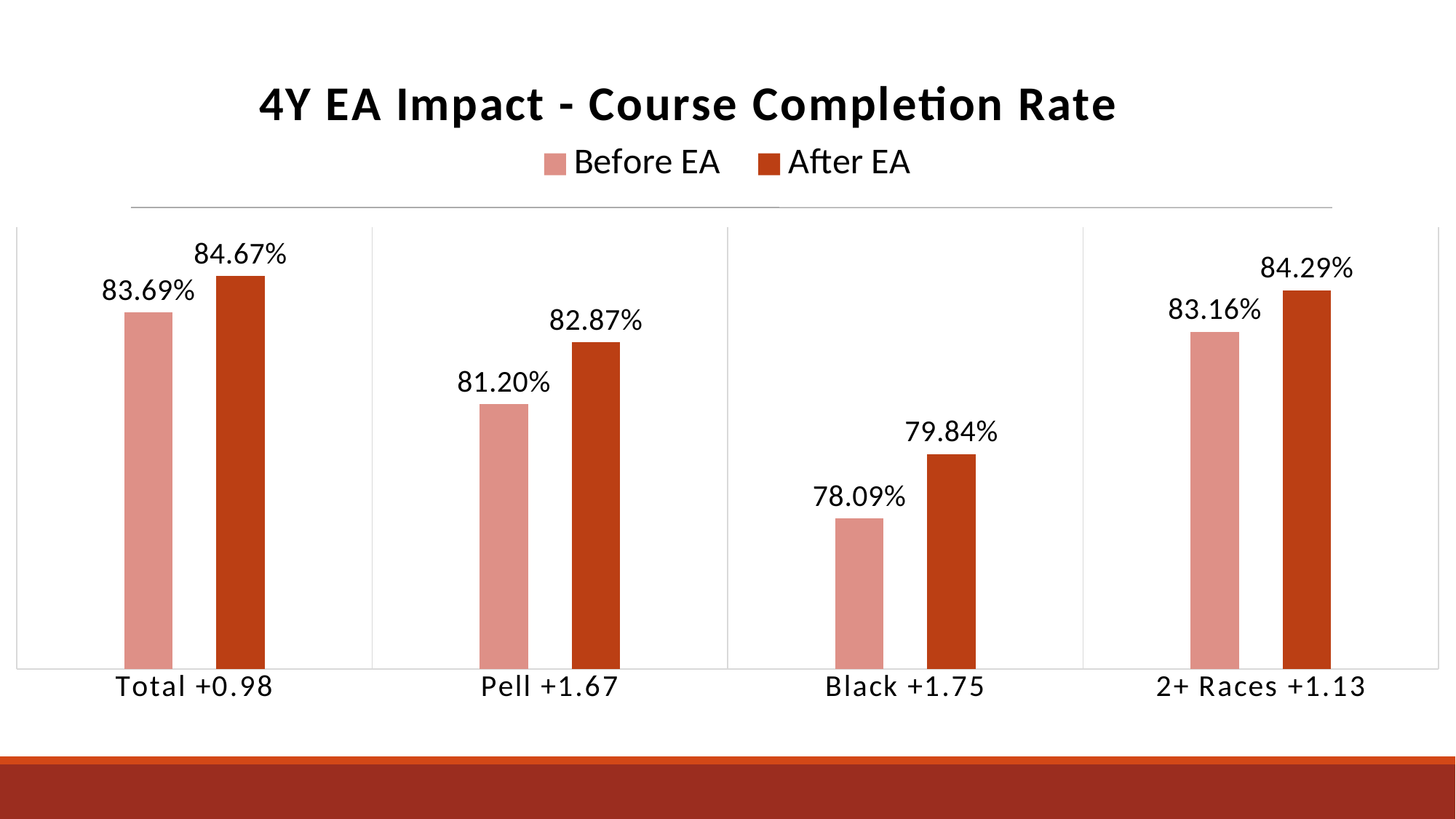
How many series does the legend list? 2 What is the After EA course completion rate for Black? 79.84% What is the Before EA course completion rate for Pell? 81.20% How many categories are shown on the x axis? 4 Which is larger, the Before EA value for 2+ Races or the Before EA value for Pell? 2+ Races What is the title of the chart? 4Y EA Impact - Course Completion Rate What kind of chart is shown on the slide? Bar chart What is the Before EA value for Total? 83.69% What is the difference between the After EA and Before EA values for Pell? 1.67% What is the After EA value for 2+ Races? 84.29% Which category has the highest After EA value? Total +0.98 Which category has the lowest Before EA value? Black +1.75